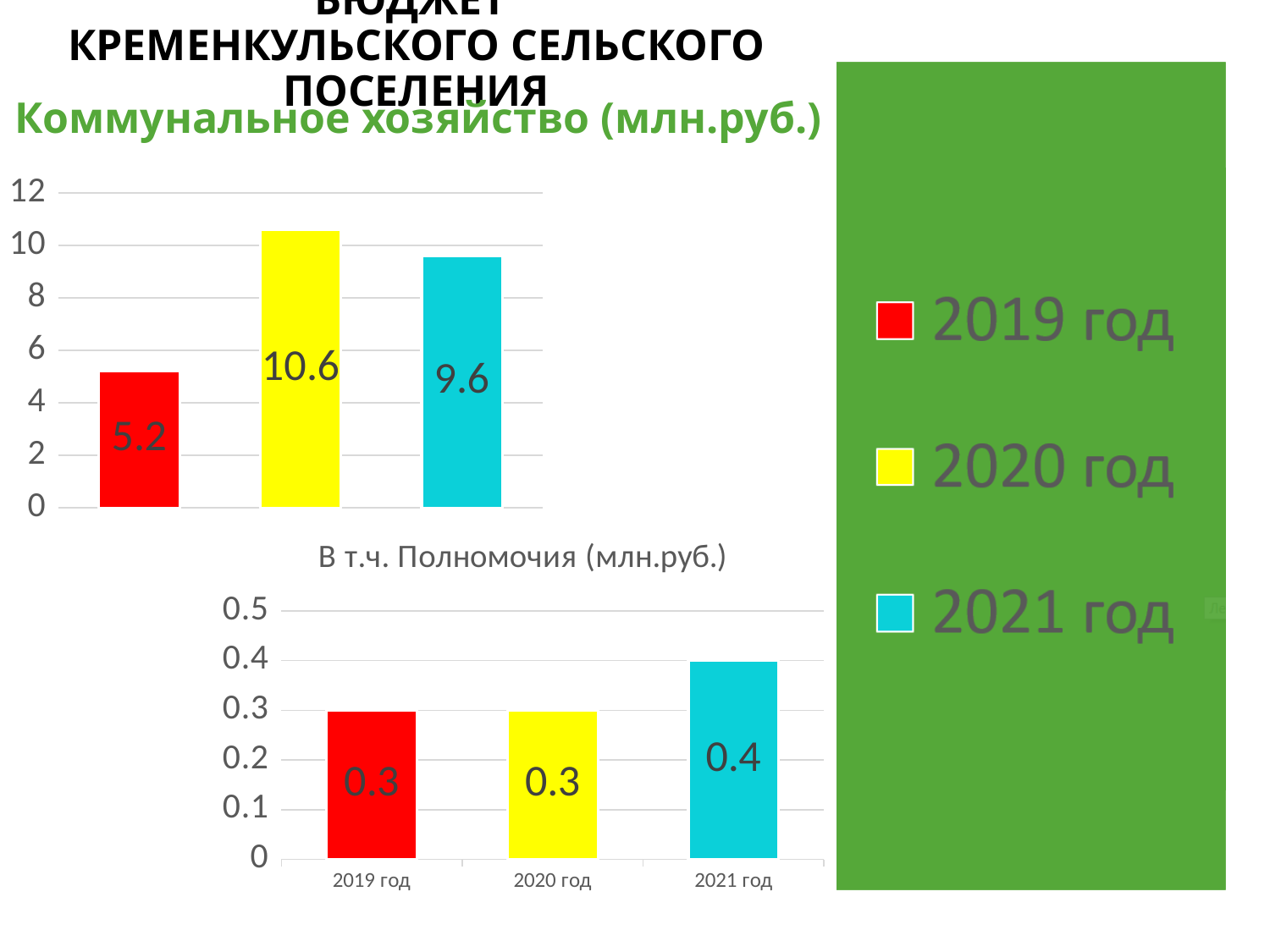
In the chart titled "В т.ч. Полномочия (млн.руб.)", which year has the highest value? 2021 год In the chart titled "Коммунальное хозяйство (млн.руб.)", is the value for 2021 год greater or less than 8? greater In the chart titled "Коммунальное хозяйство (млн.руб.)", what is the difference between the values for 2020 год and 2021 год? 1.0 How many entries does the legend on the slide list? 3 In the chart titled "В т.ч. Полномочия (млн.руб.)", what is the value for 2021 год? 0.4 In the chart titled "Коммунальное хозяйство (млн.руб.)", which year has the highest value? 2020 год In the chart titled "В т.ч. Полномочия (млн.руб.)", what is the value for 2019 год? 0.3 In the chart titled "Коммунальное хозяйство (млн.руб.)", what is the value for 2020 год? 10.6 What type of chart is the chart titled "Коммунальное хозяйство (млн.руб.)"? bar chart In the chart titled "В т.ч. Полномочия (млн.руб.)", how many bars are plotted? 3 In the chart titled "Коммунальное хозяйство (млн.руб.)", what is the value for 2019 год? 5.2 In the chart titled "Коммунальное хозяйство (млн.руб.)", which year has the lowest value? 2019 год